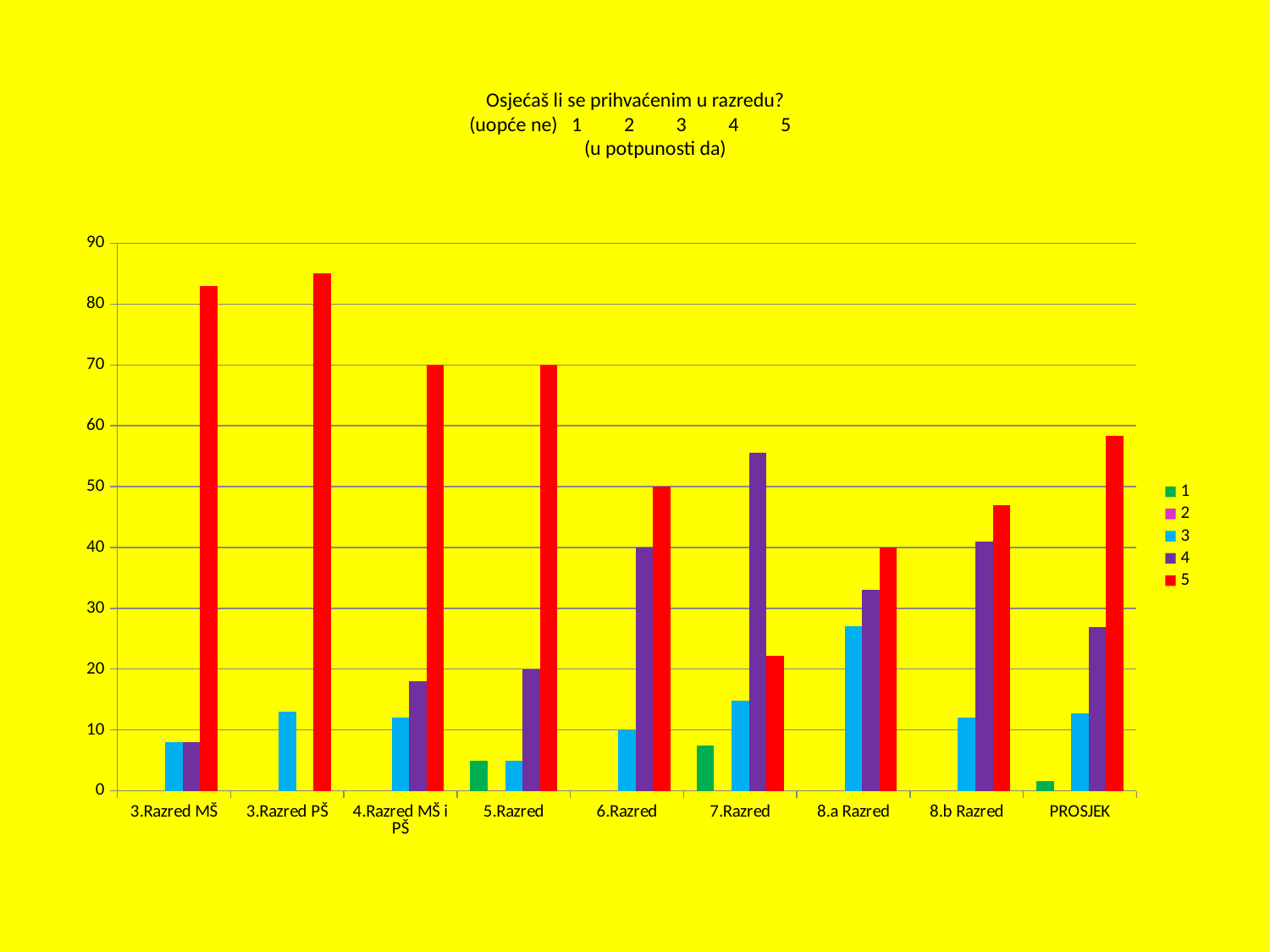
Which colour represents series 5 in the legend? red Which category has the lowest value for series 5? 7.Razred What is the value of series 5 for 4.Razred MŠ i PŠ? 70 What is the value of series 5 for 6.Razred? 50 How many categories are shown along the x axis? 9 Is the value of series 5 for 7.Razred greater or less than 30? less Is the value of series 5 for 3.Razred MŠ greater or less than 80? greater Is the value of series 5 for PROSJEK greater or less than 50? greater What kind of chart is shown on the slide? bar chart Which category has the highest value for series 4? 7.Razred How many series does the legend list? 5 Which is larger: series 4 for 6.Razred or series 4 for 7.Razred? 7.Razred